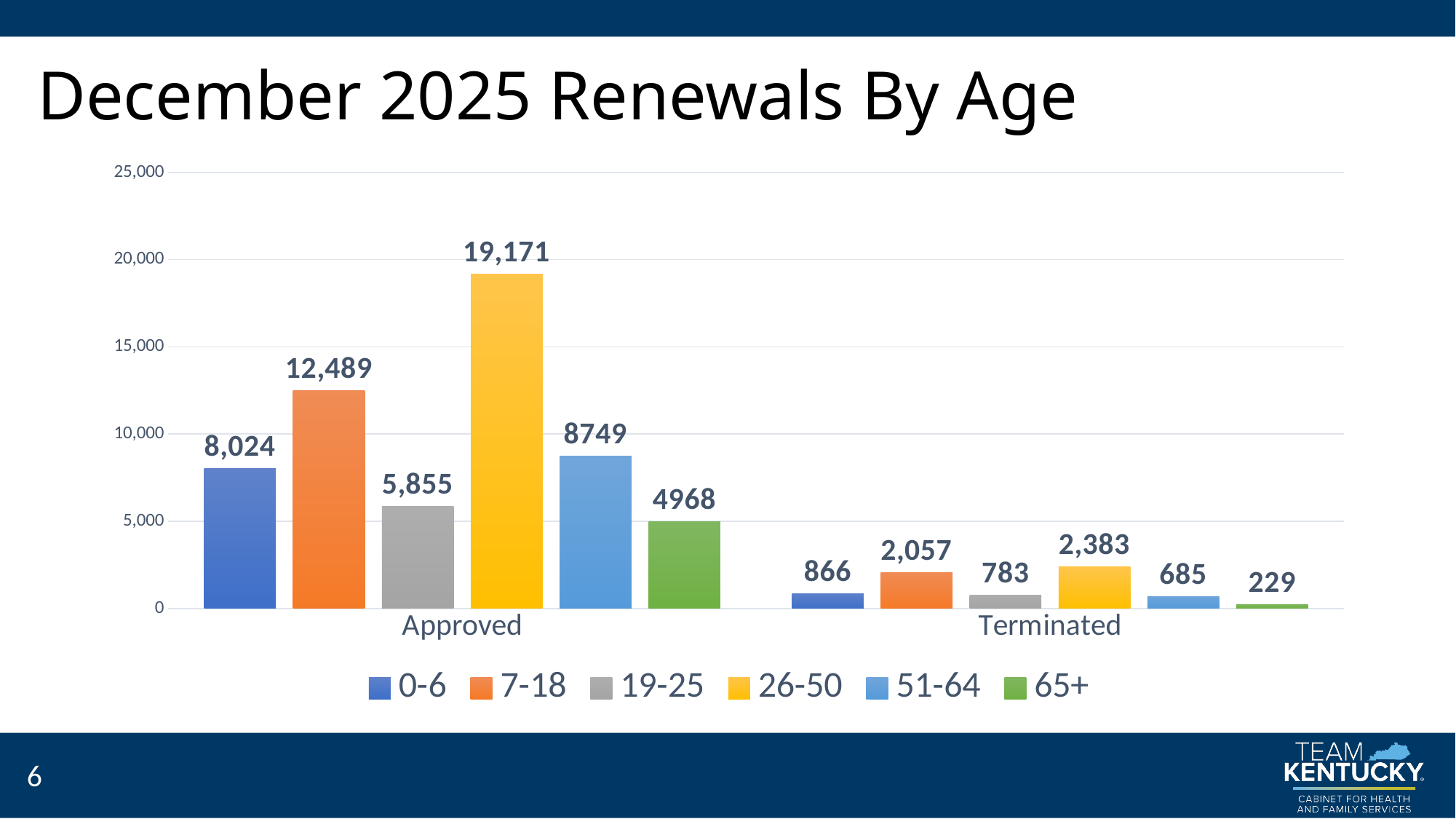
What is the Approved value for the 26-50 age group? 19,171 What kind of chart is shown on the slide? Bar chart Is the Approved value for 19-25 greater or less than 5,000? greater Which is larger: the Terminated value for 26-50 or for 7-18? 26-50 What is the title of the slide? December 2025 Renewals By Age Which age group has the lowest Terminated value? 65+ How many categories are shown on the x axis? 2 How many series does the legend list? 6 What is the difference between the Approved values for 7-18 and 0-6? 4,465 Which age group has the highest Approved value? 26-50 What is the Approved value for the 51-64 age group? 8749 What is the Terminated value for the 7-18 age group? 2,057